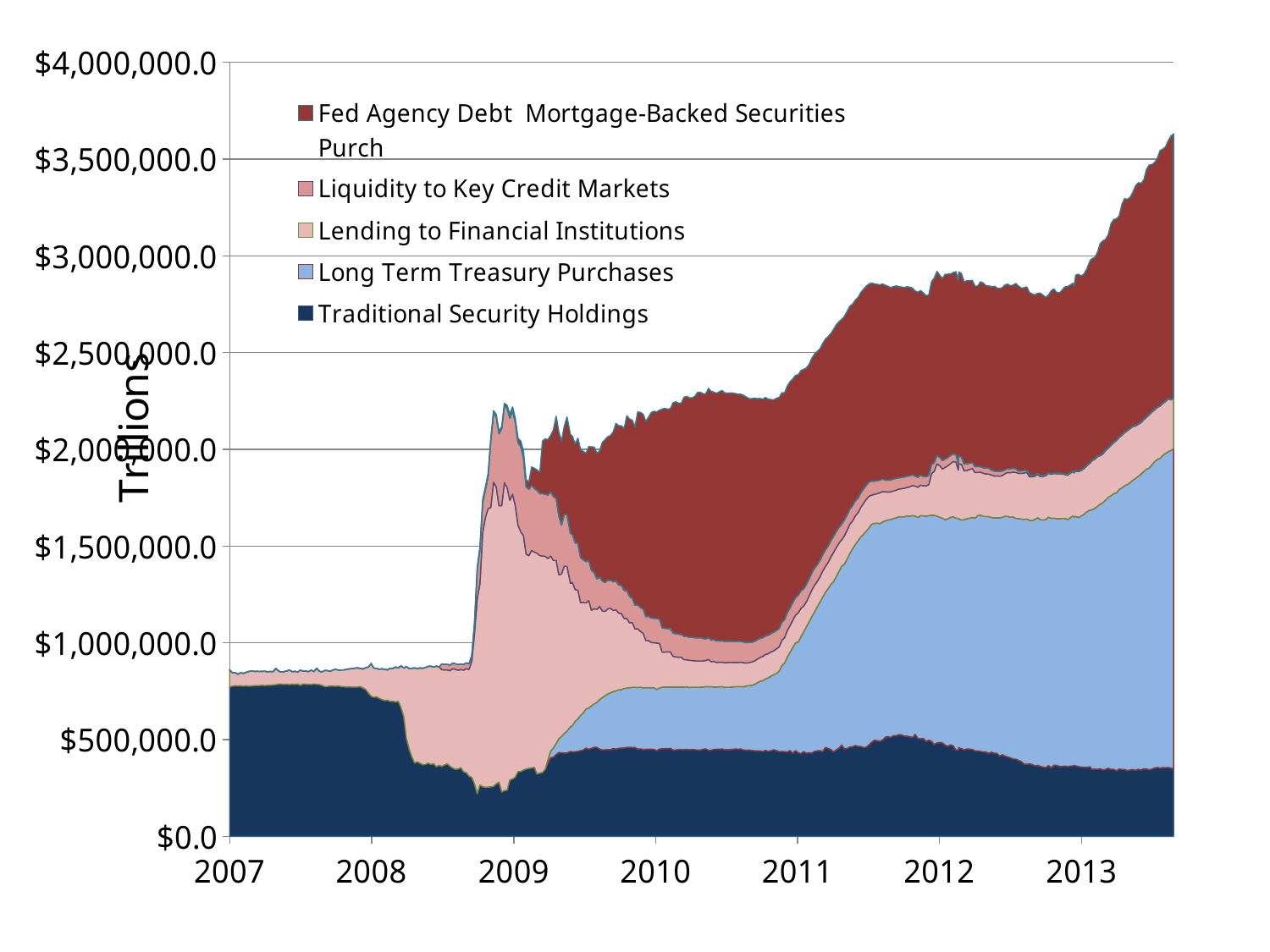
Is the total stacked value at the 2012 tick greater or less than $2,500,000.0? greater Which series is plotted at the bottom of the stack? Traditional Security Holdings Does the value for Traditional Security Holdings rise or fall from 2007 to the end of 2013? fall Is the total stacked value at the 2011 tick greater or less than $2,000,000.0? greater What kind of chart is shown on the slide? Stacked area chart How many series does the legend list? 5 How many year labels are shown on the horizontal axis? 7 What is the label on the vertical axis? Trillions Is the value for Traditional Security Holdings at the start of 2007 greater or less than $500,000.0? greater Does the total stacked value rise or fall from 2007 to the end of 2013? rise